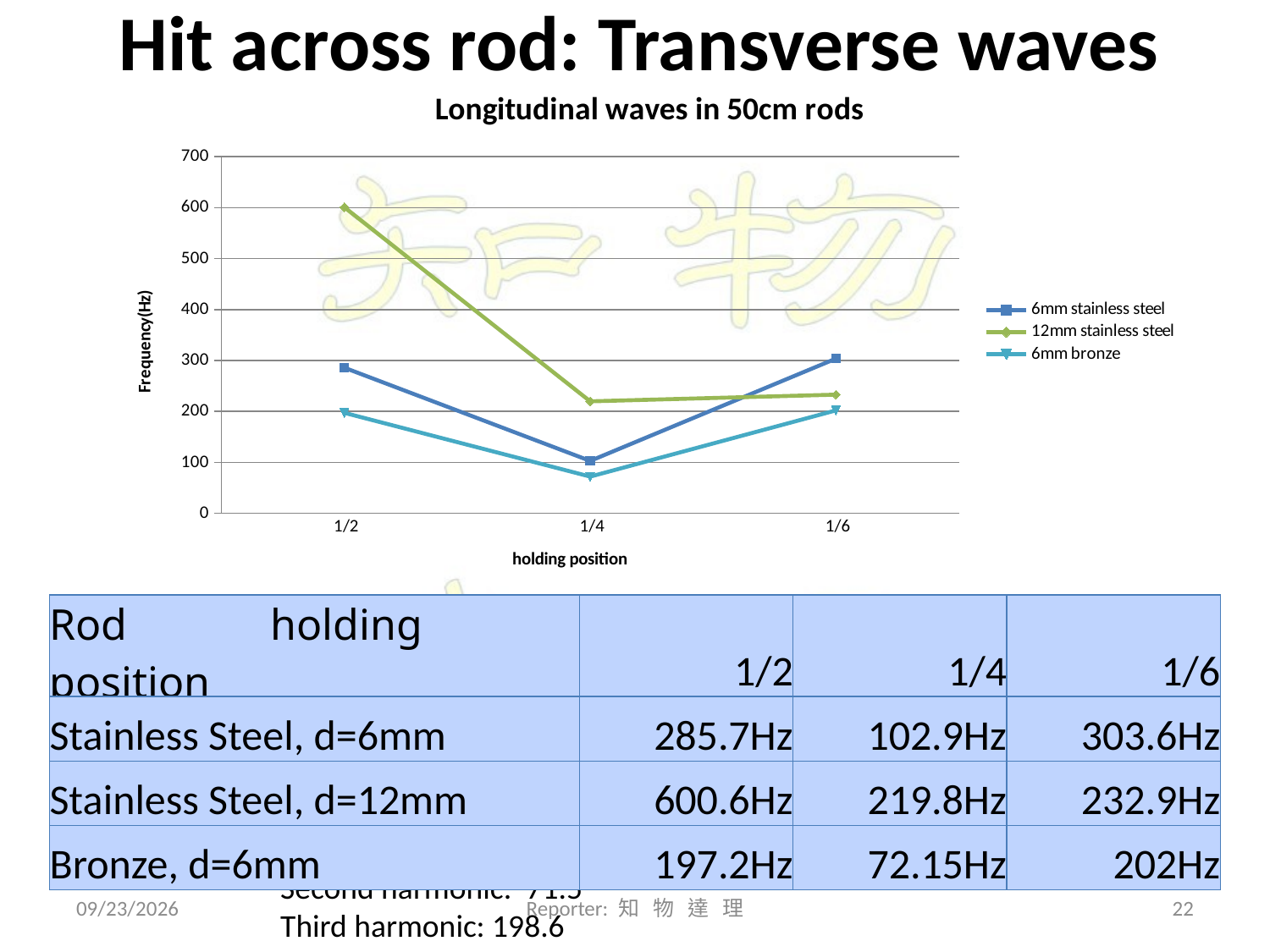
Which series has the lowest frequency at holding position 1/4? 6mm bronze Is the value for 12mm stainless steel at holding position 1/2 greater or less than 500? greater Which series has the highest frequency at holding position 1/2? 12mm stainless steel What is the frequency for the 6mm bronze rod at holding position 1/4? 72.15Hz What kind of chart is shown on the slide? line chart How many holding positions are plotted along the x axis? 3 Is the value for 6mm stainless steel at holding position 1/4 greater or less than 200? less How many series does the chart legend list? 3 What is the difference between the 6mm stainless steel frequencies at holding positions 1/6 and 1/4? 200.7Hz Which is larger at holding position 1/6: 6mm stainless steel or 12mm stainless steel? 6mm stainless steel What is the frequency for the 12mm stainless steel rod at holding position 1/2? 600.6Hz What is the title of the chart? Longitudinal waves in 50cm rods